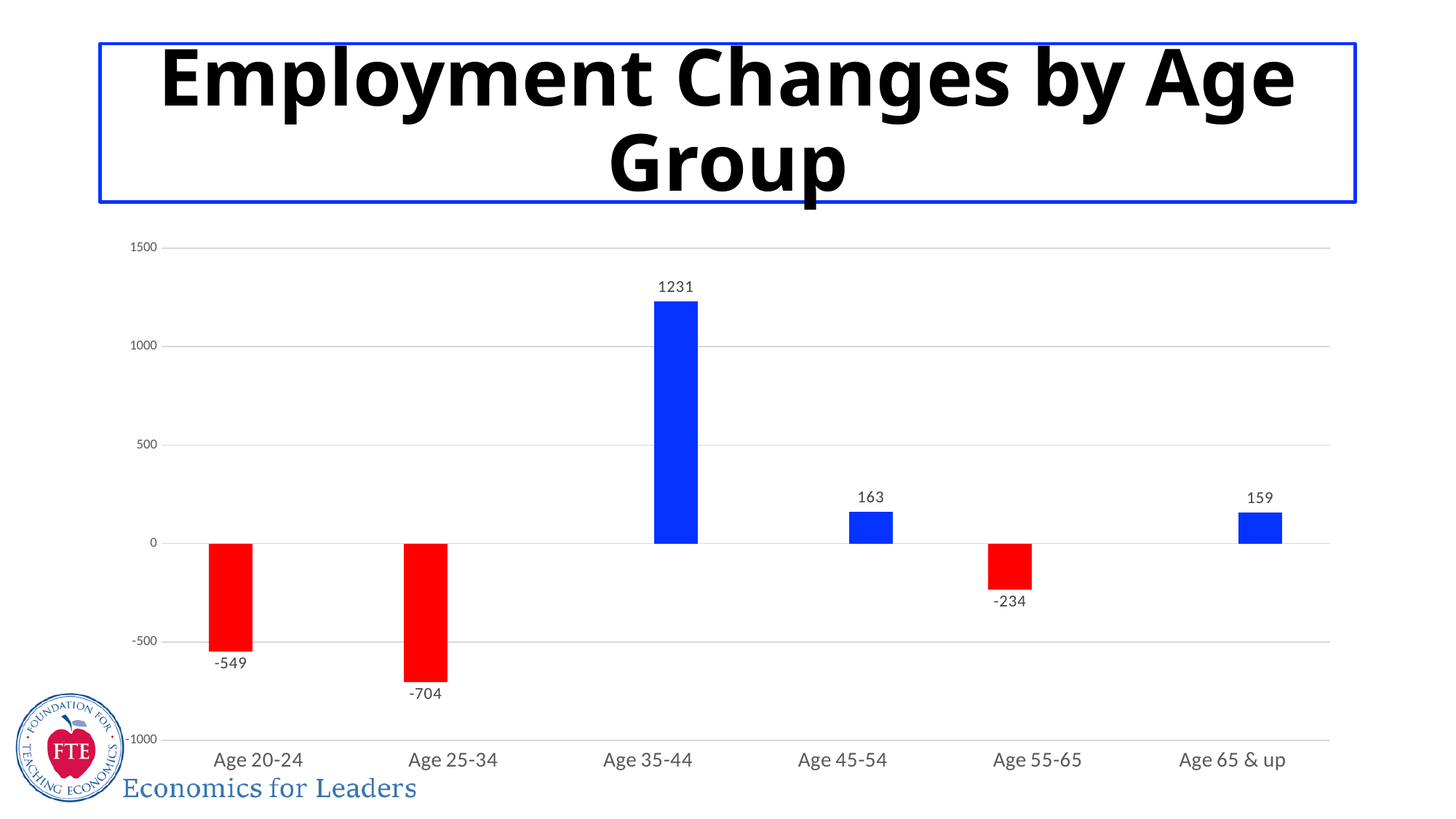
What kind of chart is shown on the slide? Bar chart What is the difference between the values for Age 35-44 and Age 45-54? 1068 Which age group has the lowest value? Age 25-34 What is the value for Age 25-34? -704 Which is larger, the value for Age 20-24 or the value for Age 55-65? Age 55-65 What colour are the bars with negative values? Red What is the difference between the values for Age 20-24 and Age 25-34? 155 What is the value for Age 35-44? 1231 Which age group has the highest value? Age 35-44 What is the value for Age 55-65? -234 What is the value for Age 65 & up? 159 How many age groups are shown on the chart? 6